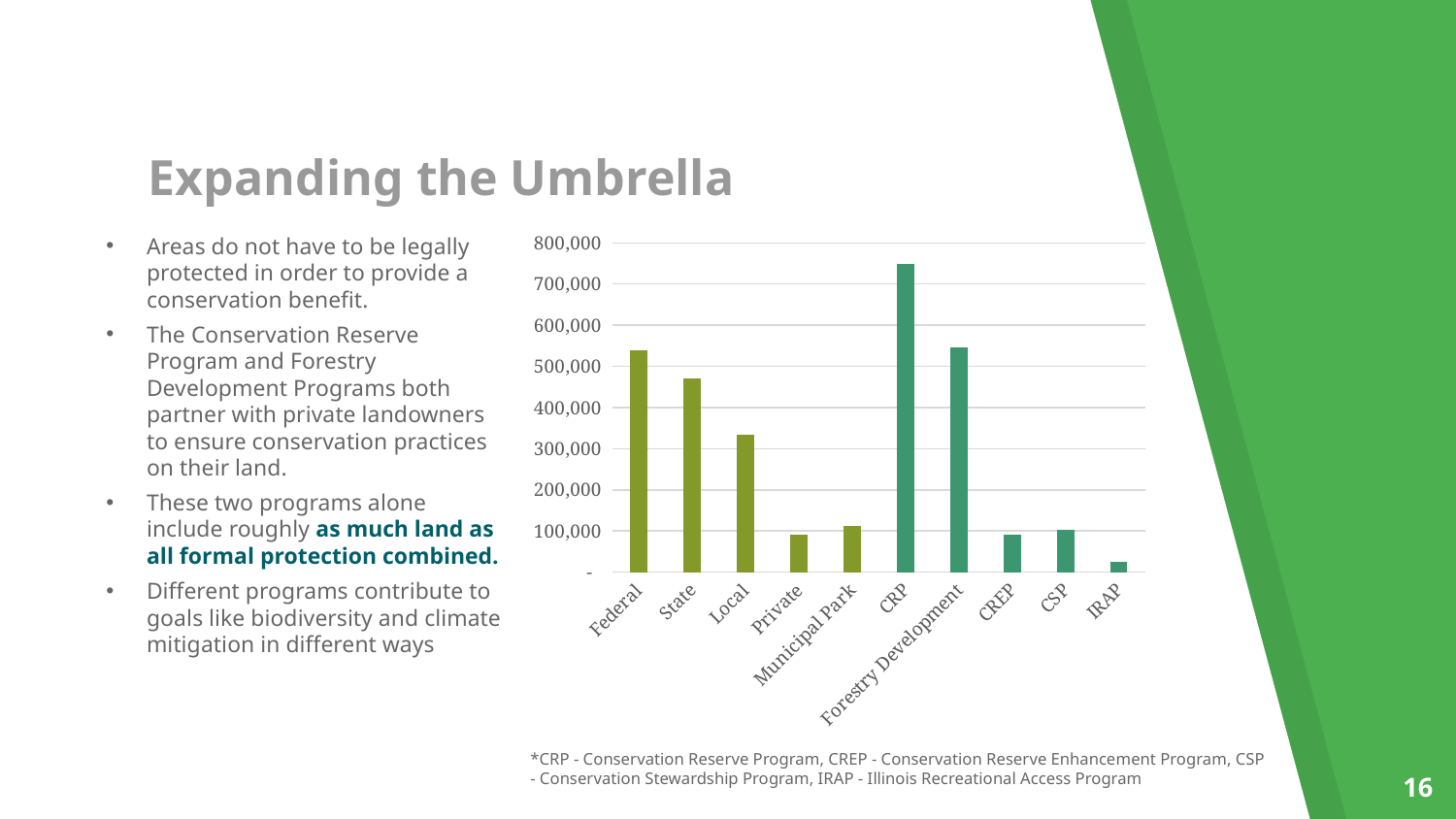
What kind of chart is shown on the slide? Bar chart Is the value for IRAP greater or less than 100,000? less Which is larger, the value for Local or the value for Private? Local Is the value for CRP greater or less than 700,000? greater Which category has the highest value on the chart? CRP Is the value for State greater or less than 500,000? less What is the highest value shown on the vertical axis of the chart? 800,000 Which category has the lowest value on the chart? IRAP Which is larger, the value for Federal or the value for State? Federal How many categories are plotted on the chart? 10